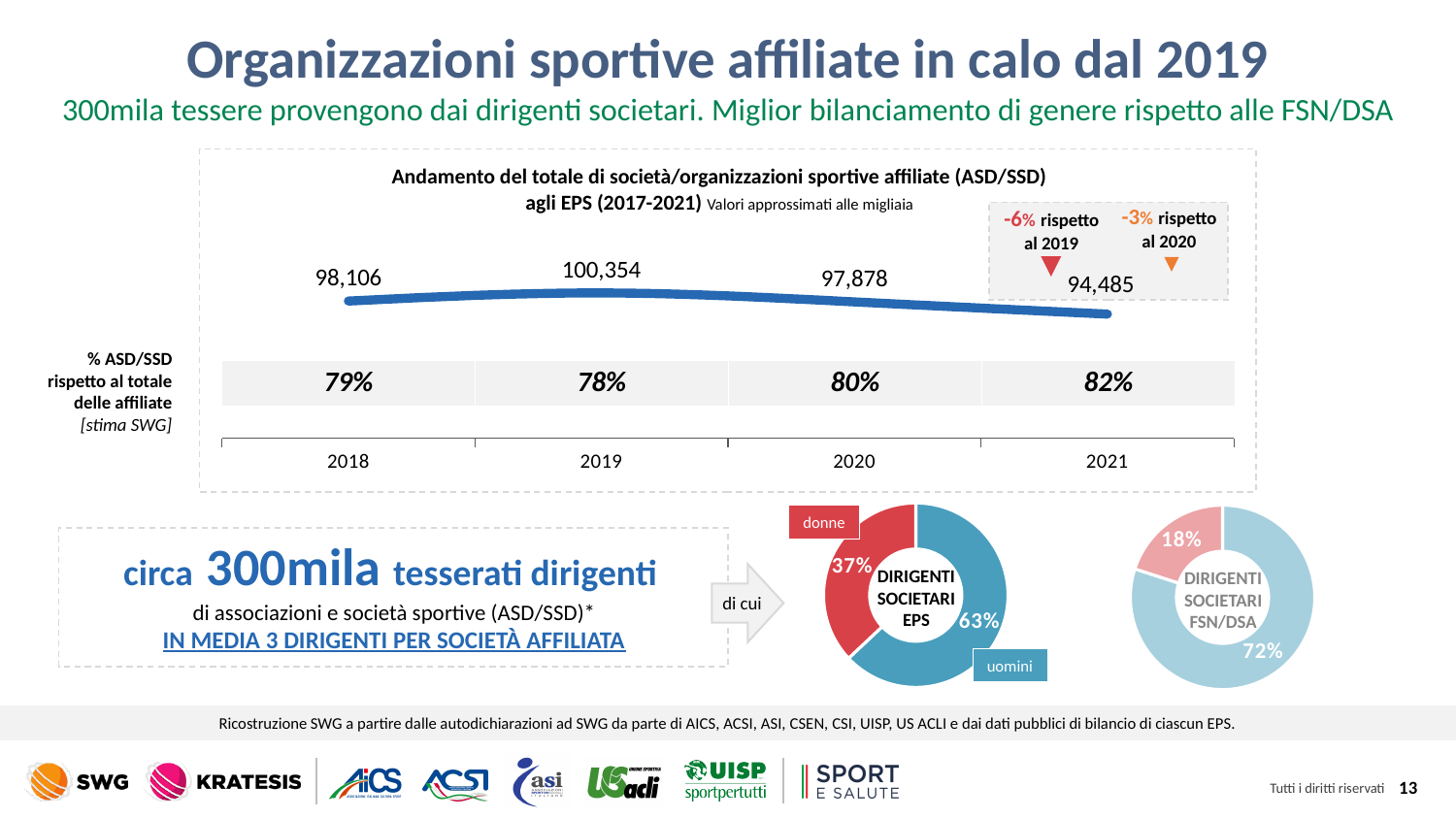
In the row '% ASD/SSD rispetto al totale delle affiliate' below the line chart, what is the percentage for 2021? 82% In the line chart 'Andamento del totale di società/organizzazioni sportive affiliate', is the value for 2018 larger or smaller than the value for 2020? larger In the line chart 'Andamento del totale di società/organizzazioni sportive affiliate', which year has the lowest value? 2021 In the line chart 'Andamento del totale di società/organizzazioni sportive affiliate', which year has the highest value? 2019 In the donut chart 'DIRIGENTI SOCIETARI FSN/DSA', what is the value of the smaller (pink) slice? 18% In the line chart 'Andamento del totale di società/organizzazioni sportive affiliate (ASD/SSD) agli EPS (2017-2021)', what is the value for 2019? 100,354 How many years are plotted in the line chart 'Andamento del totale di società/organizzazioni sportive affiliate'? 4 In the line chart 'Andamento del totale di società/organizzazioni sportive affiliate', do the values rise or fall from 2019 to 2021? fall In the donut chart 'DIRIGENTI SOCIETARI EPS', what share is labelled 'donne'? 37% In the donut chart 'DIRIGENTI SOCIETARI EPS', what share is labelled 'uomini'? 63% In the line chart 'Andamento del totale di società/organizzazioni sportive affiliate', what is the value for 2021? 94,485 In the line chart 'Andamento del totale di società/organizzazioni sportive affiliate', what is the difference between the 2019 value and the 2021 value? 5,869